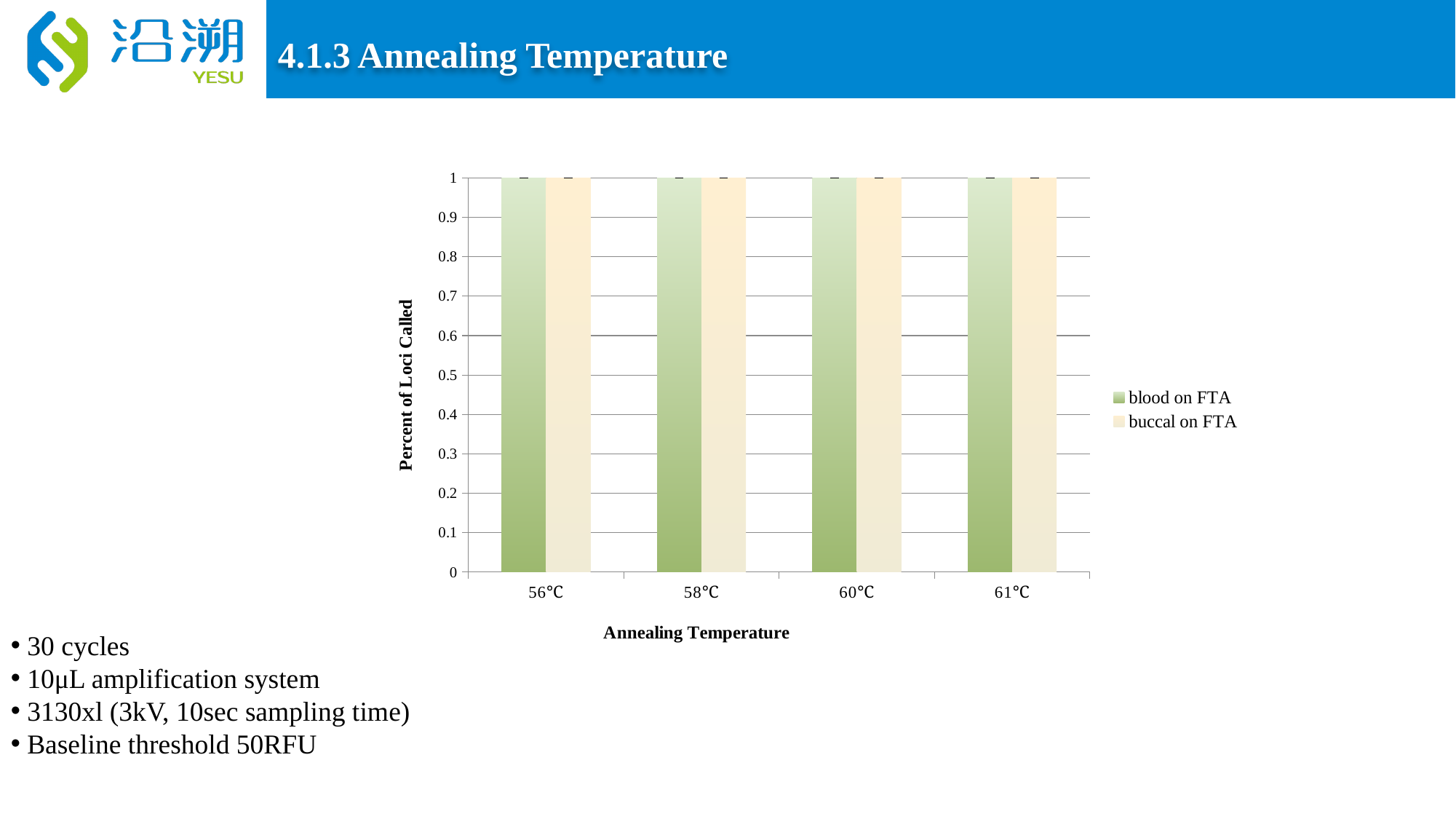
Is the value for buccal on FTA at 58°C greater or less than 0.5? greater What is the label of the y axis? Percent of Loci Called What is the value for buccal on FTA at 61°C? 1 Do the values for blood on FTA rise, fall, or stay flat as the annealing temperature increases from 56°C to 61°C? stay flat What is the value for blood on FTA at 56°C? 1 How many annealing temperature categories are shown on the x axis? 4 What is the difference between the blood on FTA and buccal on FTA values at 60°C? 0 What is the value for blood on FTA at 60°C? 1 How many series does the legend list? 2 What is the label of the x axis? Annealing Temperature What kind of chart is shown on the slide? bar chart